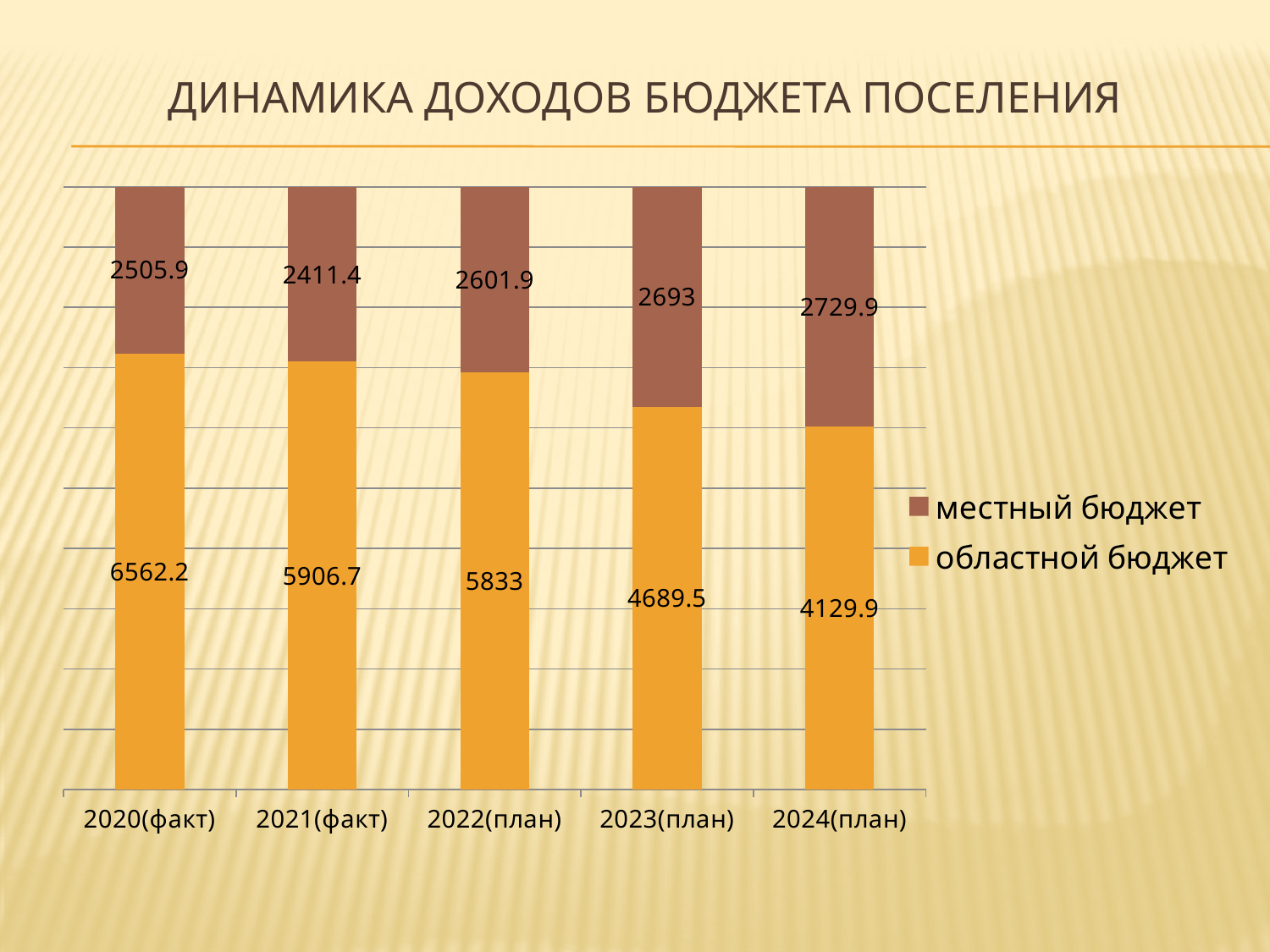
What is the value for областной бюджет in 2024(план)? 4129.9 How many years are shown on the x axis? 5 What is the sum of the two labeled values for 2021(факт)? 8318.1 Which year has the highest value for областной бюджет? 2020(факт) Do the областной бюджет values rise or fall from 2020(факт) to 2024(план)? Fall What is the value for местный бюджет in 2023(план)? 2693 What is the difference between the областной бюджет values for 2020(факт) and 2024(план)? 2432.3 What is the value for областной бюджет in 2020(факт)? 6562.2 Which is larger: местный бюджет in 2022(план) or местный бюджет in 2021(факт)? 2022(план) Which year has the lowest value for местный бюджет? 2021(факт) How many series does the legend list? 2 What kind of chart is shown on the slide? Stacked bar chart